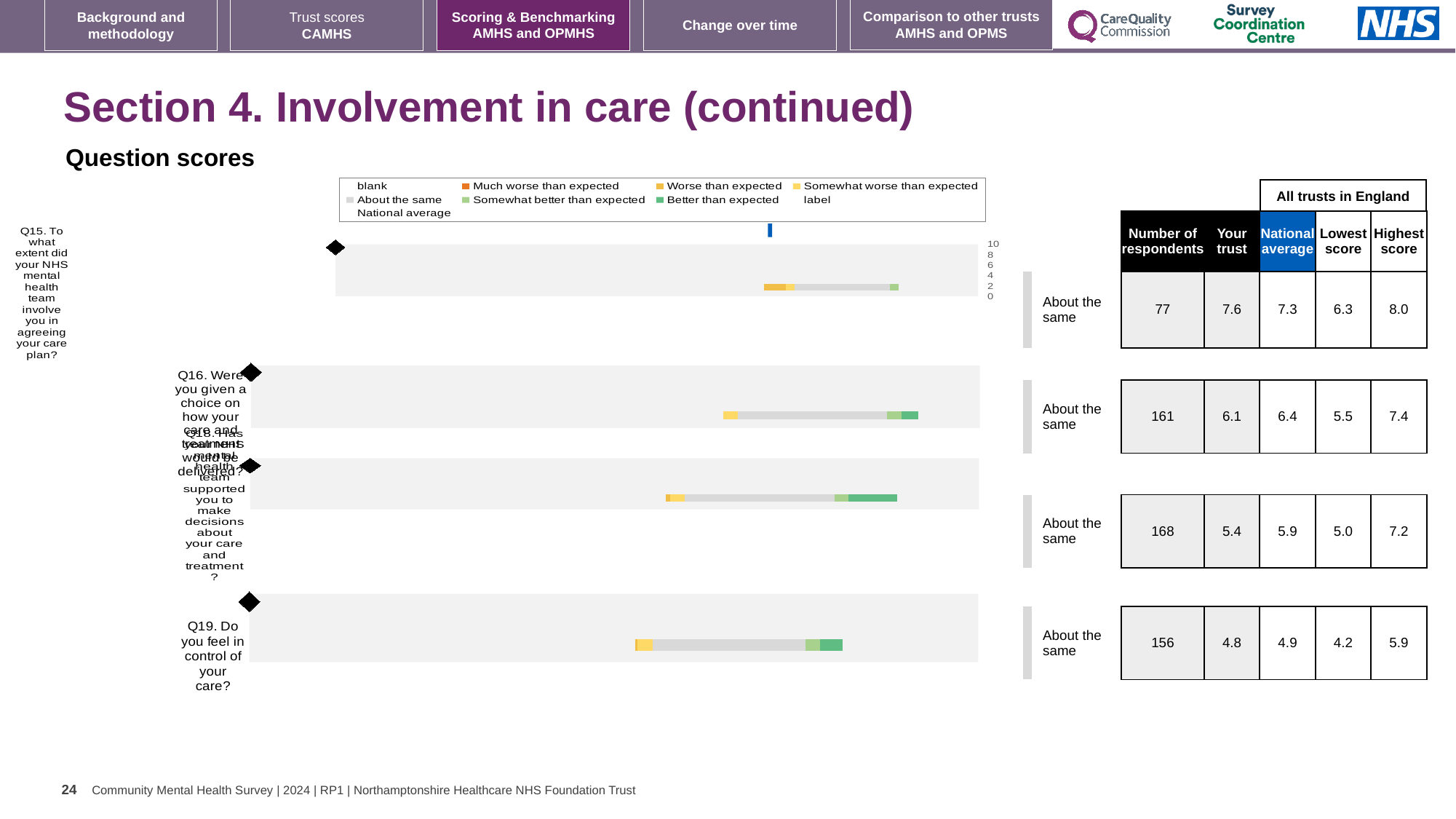
How many entries does the legend of the question scores chart list? 9 Which legend entry in the question scores chart is shown in orange? Much worse than expected What kind of chart is used to show the question scores on this slide? bar chart Which question has the lowest 'Your trust' score in the table beside the chart? Q19 In the table beside the chart, what is the national average for Q19 (Do you feel in control of your care)? 4.9 What is the heading above the question scores chart? Question scores How many survey questions are plotted in the question scores chart? 4 In the table beside the chart, how many respondents answered Q16? 161 For Q15, what is the difference between the highest score and the lowest score shown in the table? 1.7 In the table beside the chart, what is the 'Your trust' score for Q15 (involving you in agreeing your care plan)? 7.6 For Q18, is the 'Your trust' score or the national average larger in the table beside the chart? National average Which question has the highest 'Your trust' score in the table beside the chart? Q15